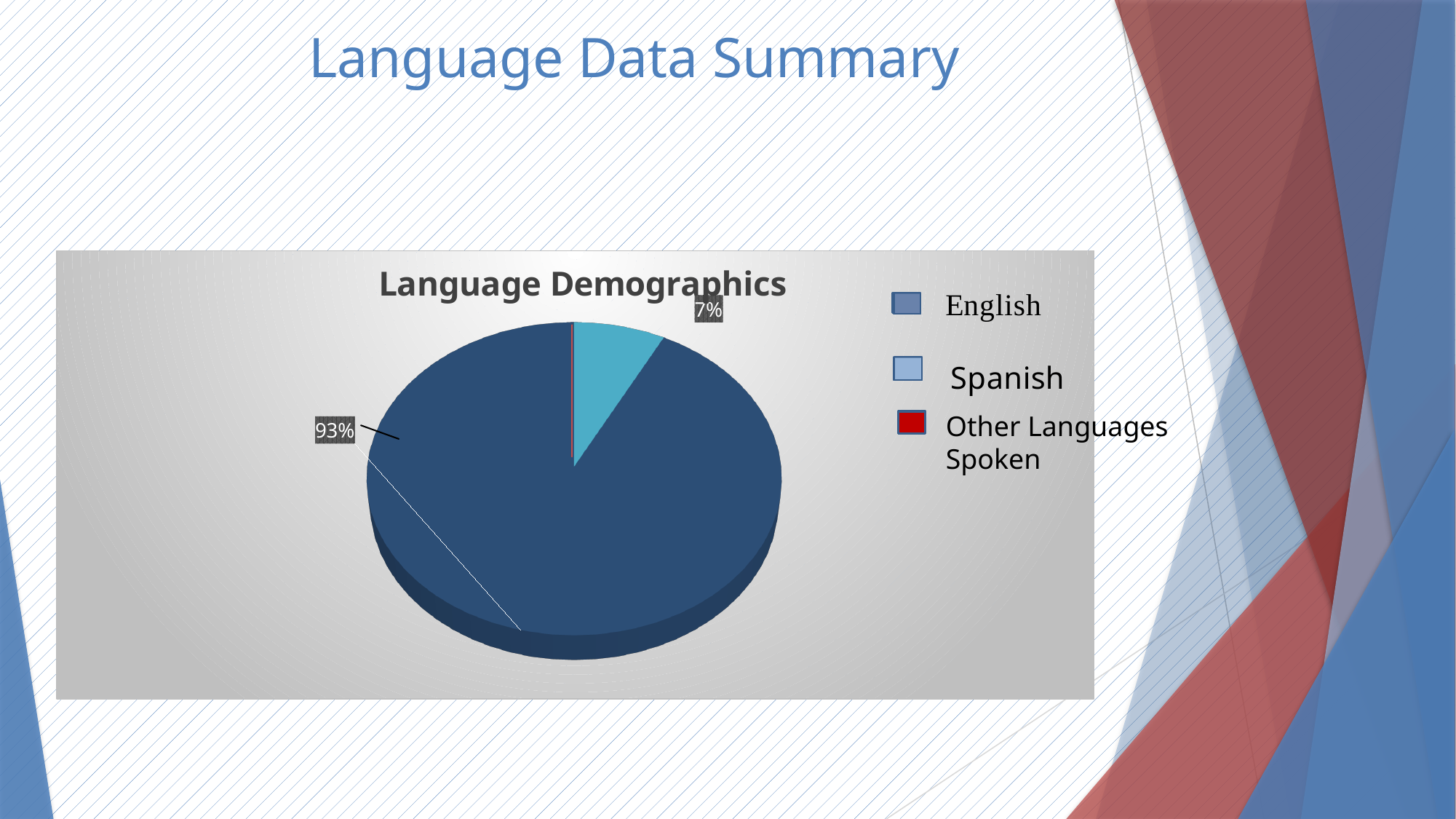
Which category has the smallest slice in the Language Demographics pie chart? Other Languages Spoken What percentage of the pie does English account for in the Language Demographics chart? 93% What kind of chart is shown on the slide? Pie chart Which slice is larger, English or Spanish? English What is the title of the chart on the slide? Language Demographics Is the share for Spanish greater or less than 50%? less How many categories does the legend of the Language Demographics chart list? 3 What percentage of the pie does Spanish account for in the Language Demographics chart? 7% What are the three entries listed in the chart's legend? English, Spanish, Other Languages Spoken By how many percentage points does the English slice exceed the Spanish slice? 86 percentage points Which language has the largest slice in the Language Demographics pie chart? English